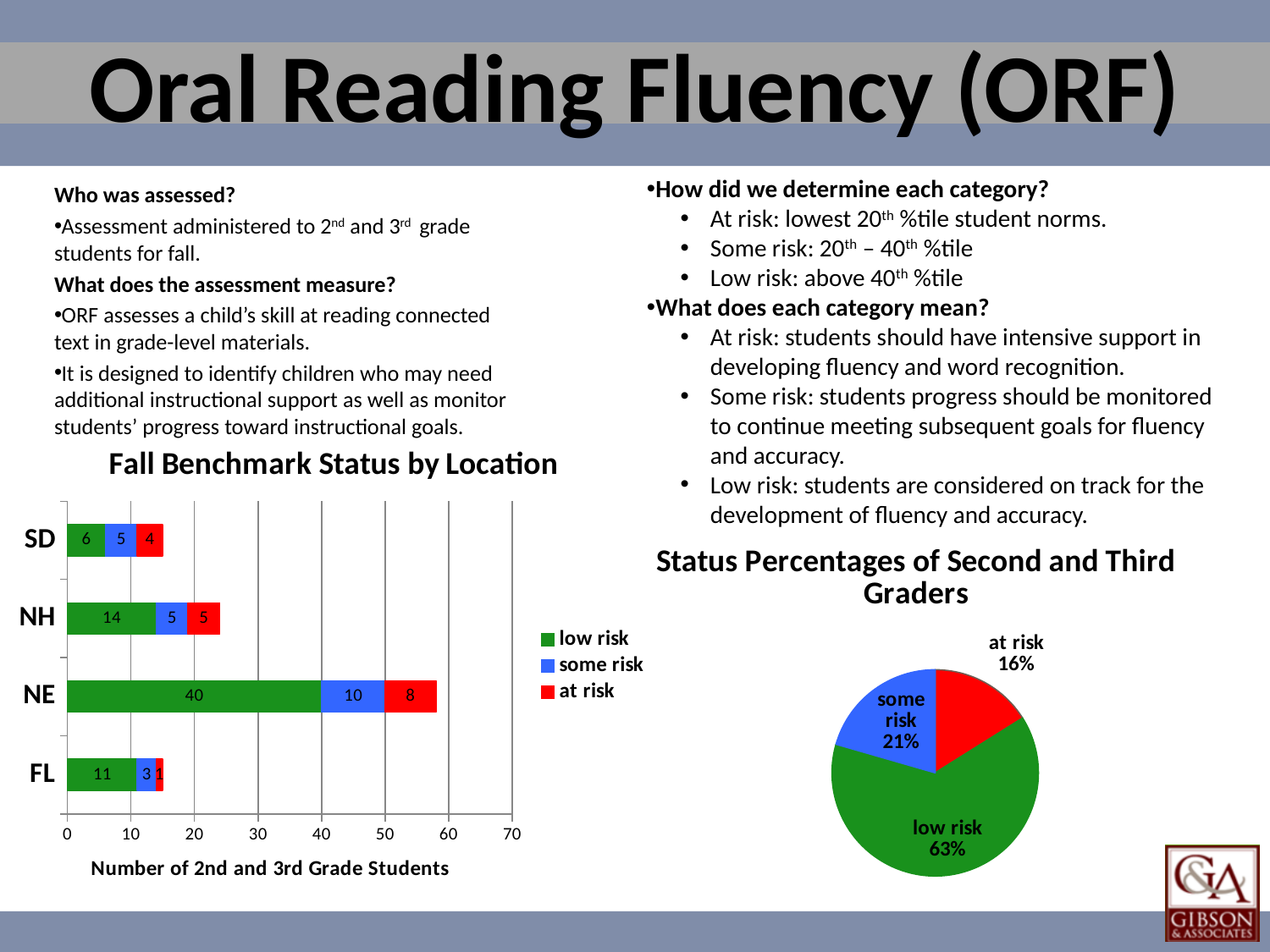
In the 'Fall Benchmark Status by Location' chart, how many locations are shown? 4 What kind of chart is 'Fall Benchmark Status by Location'? Bar chart In the 'Status Percentages of Second and Third Graders' pie chart, which category has the smallest share? at risk In the 'Fall Benchmark Status by Location' chart, what is the low risk value for NE? 40 In the 'Fall Benchmark Status by Location' chart, what is the difference between the low risk values for NH and SD? 8 In the 'Status Percentages of Second and Third Graders' pie chart, what share is low risk? 63% In the 'Fall Benchmark Status by Location' chart, what is the at risk value for SD? 4 In the 'Fall Benchmark Status by Location' chart, which location has the lowest at risk value? FL In the 'Fall Benchmark Status by Location' chart, how many series does the legend list? 3 In the 'Fall Benchmark Status by Location' chart, what is the total number of students for NE? 58 In the 'Fall Benchmark Status by Location' chart, what is the some risk value for FL? 3 In the 'Fall Benchmark Status by Location' chart, which location has the highest low risk value? NE